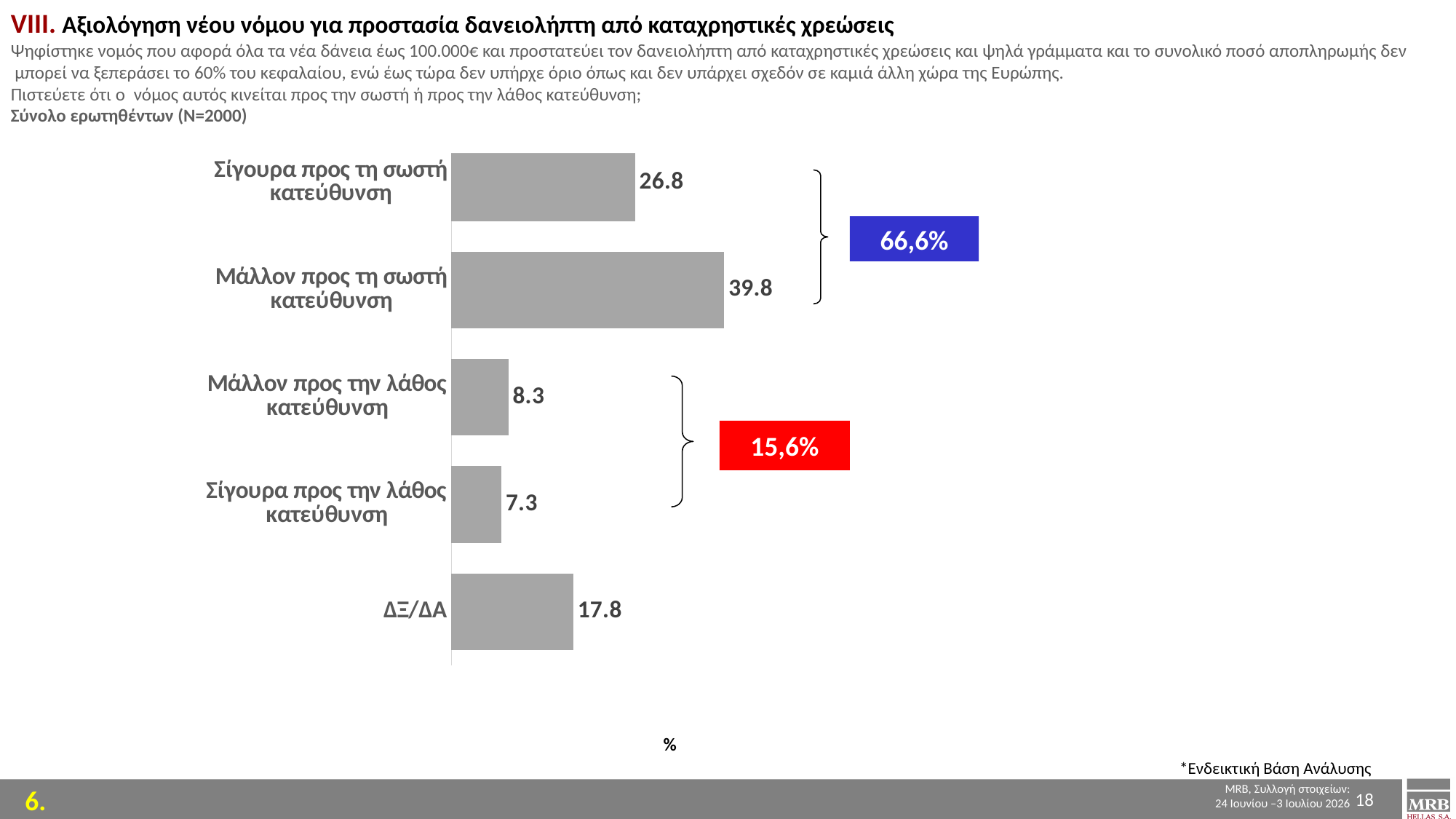
What combined percentage is shown in the red box for the two "λάθος κατεύθυνση" categories? 15,6% How many categories are shown in the chart? 5 What is the difference between the values for "Μάλλον προς τη σωστή κατεύθυνση" and "Σίγουρα προς τη σωστή κατεύθυνση"? 13.0 Which is larger: the value for "ΔΞ/ΔΑ" or the value for "Μάλλον προς την λάθος κατεύθυνση"? ΔΞ/ΔΑ What kind of chart is shown on the slide? Bar chart What is the value for "ΔΞ/ΔΑ"? 17.8 What is the difference between the values for "Μάλλον προς την λάθος κατεύθυνση" and "Σίγουρα προς την λάθος κατεύθυνση"? 1.0 What is the value for "Σίγουρα προς την λάθος κατεύθυνση"? 7.3 Which category has the highest value? Μάλλον προς τη σωστή κατεύθυνση What combined percentage is shown in the blue box for the two "σωστή κατεύθυνση" categories? 66,6% Which category has the lowest value? Σίγουρα προς την λάθος κατεύθυνση What is the value for "Μάλλον προς τη σωστή κατεύθυνση"? 39.8